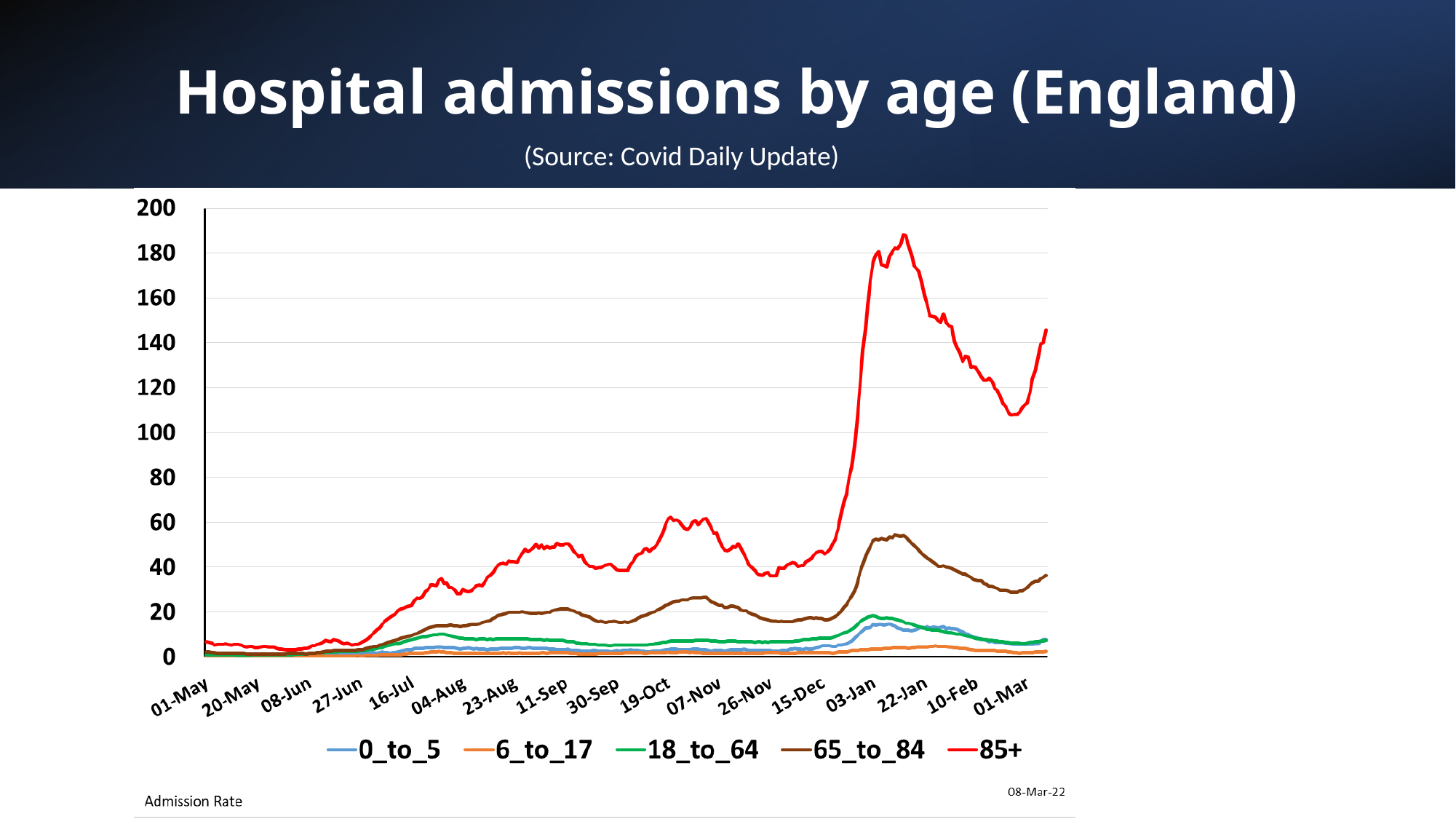
How many series does the legend list? 5 Does the 85+ line rise or fall between 15-Dec and 03-Jan? rise Which age group is shown by the red line in the legend? 85+ Is the peak value for 65_to_84 around 03-Jan greater or less than 40? greater Which age group has the lowest admission rate across the chart? 6_to_17 Is the peak value for 85+ around 22-Jan greater or less than 180? greater At 03-Jan, which is larger: the value for 85+ or the value for 65_to_84? 85+ What is the title of the chart? Hospital admissions by age (England) Which age group reaches the highest admission rate on the chart? 85+ Is the value for 85+ at 01-May greater or less than 20? less What kind of chart is shown on the slide? line chart